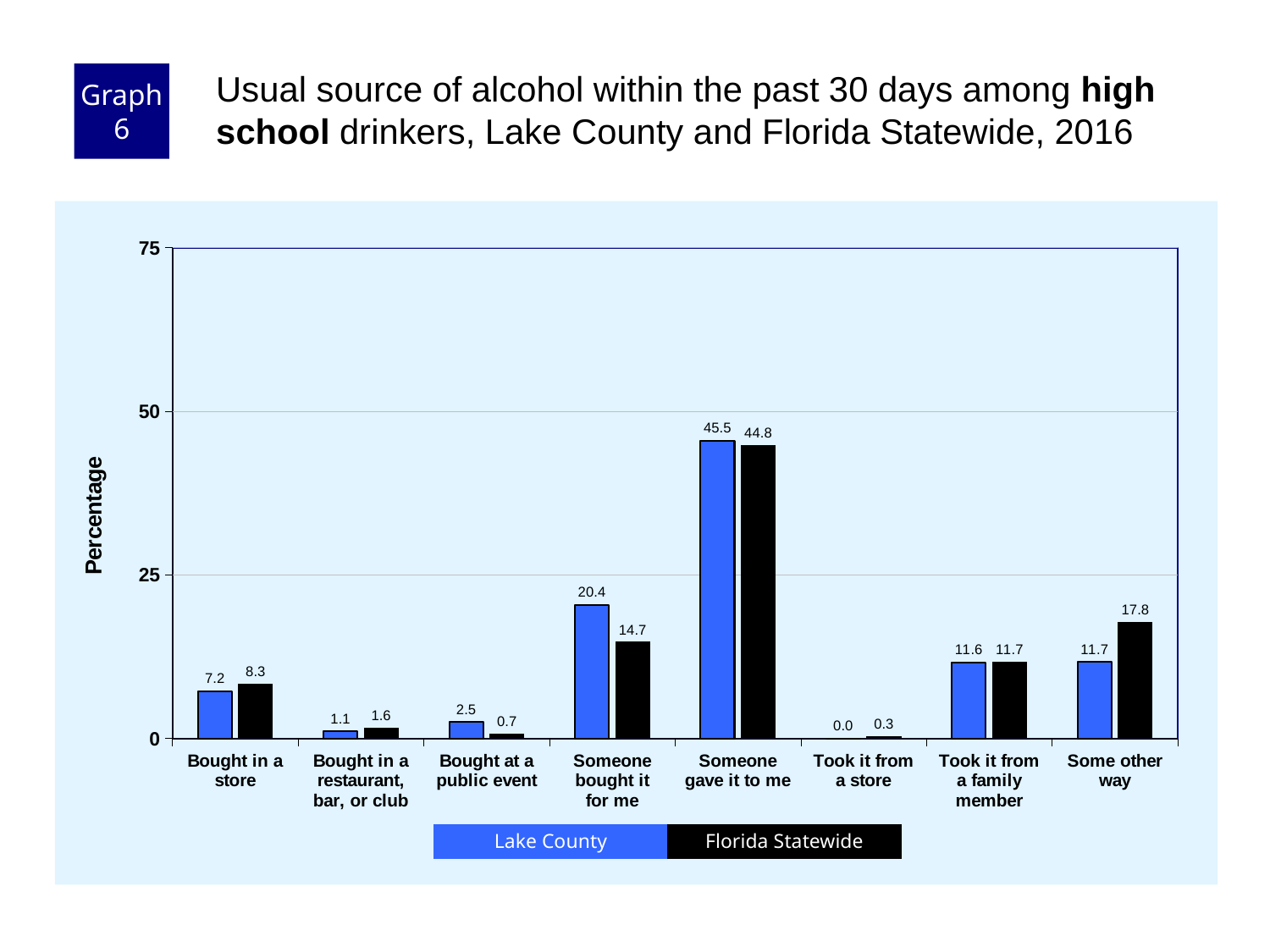
What kind of chart is shown on the slide? bar chart What is the Lake County value for "Someone gave it to me"? 45.5 What is the difference between the Lake County and Florida Statewide values for "Someone bought it for me"? 5.7 What is the Florida Statewide value for "Some other way"? 17.8 How many categories are shown on the x axis? 8 How many series does the legend list? 2 Which category has the lowest Lake County value? Took it from a store Which is larger for "Bought at a public event": Lake County or Florida Statewide? Lake County Which category has the highest Florida Statewide value? Someone gave it to me What is the Lake County value for "Took it from a store"? 0.0 What is the label of the y axis? Percentage Is the Florida Statewide value for "Someone gave it to me" greater or less than 50? less